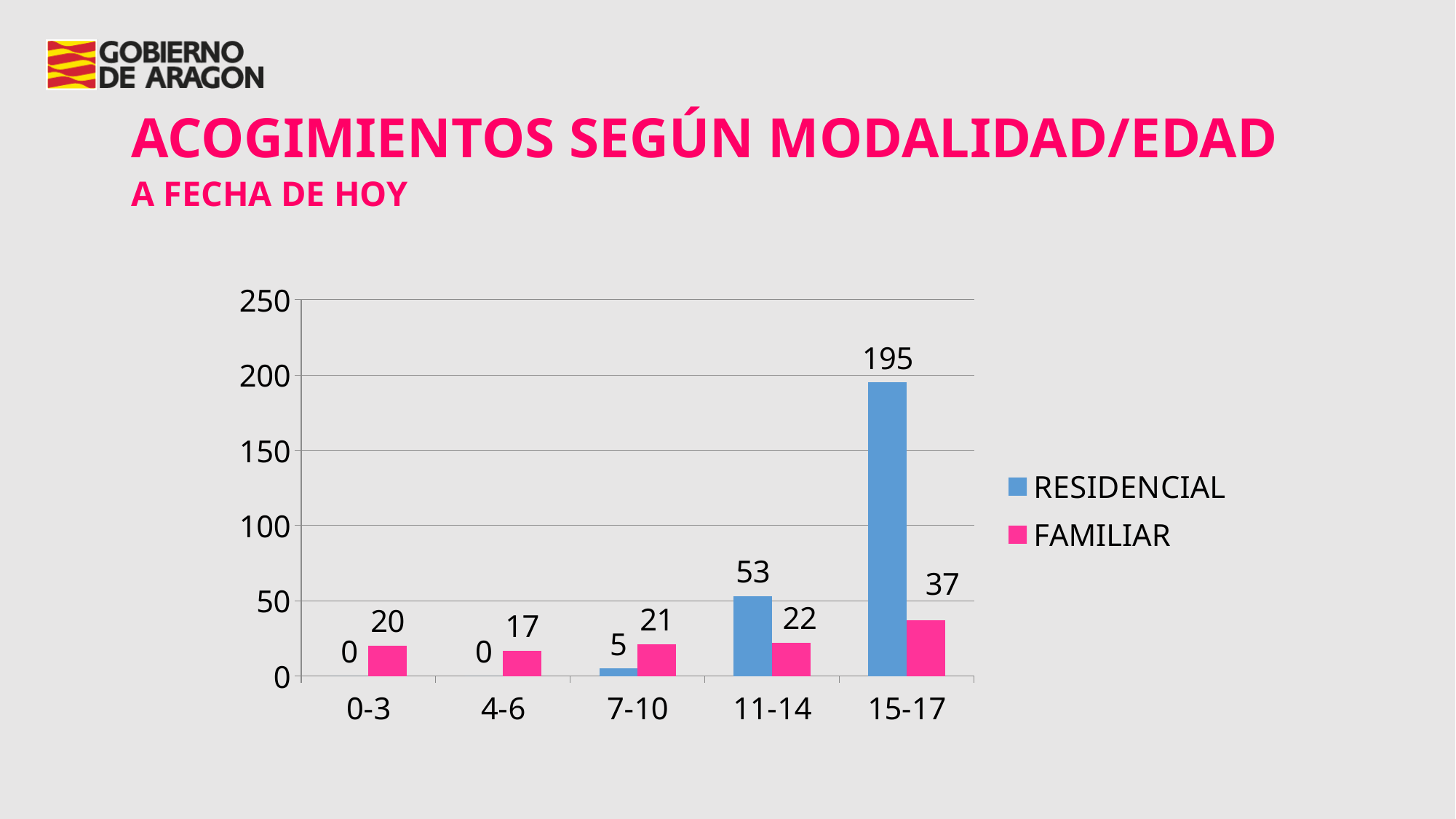
What is the RESIDENCIAL value for the 15-17 age group? 195 Which colour represents the FAMILIAR series? Pink What kind of chart is shown on the slide? Bar chart What is the FAMILIAR value for the 11-14 age group? 22 How many age groups are shown on the x axis? 5 What is the RESIDENCIAL value for the 7-10 age group? 5 For the 11-14 age group, which is larger, RESIDENCIAL or FAMILIAR? RESIDENCIAL Which age group has the lowest FAMILIAR value? 4-6 Which age group has the highest RESIDENCIAL value? 15-17 What is the difference between the RESIDENCIAL and FAMILIAR values for the 15-17 age group? 158 What is the FAMILIAR value for the 0-3 age group? 20 How many series does the legend list? 2